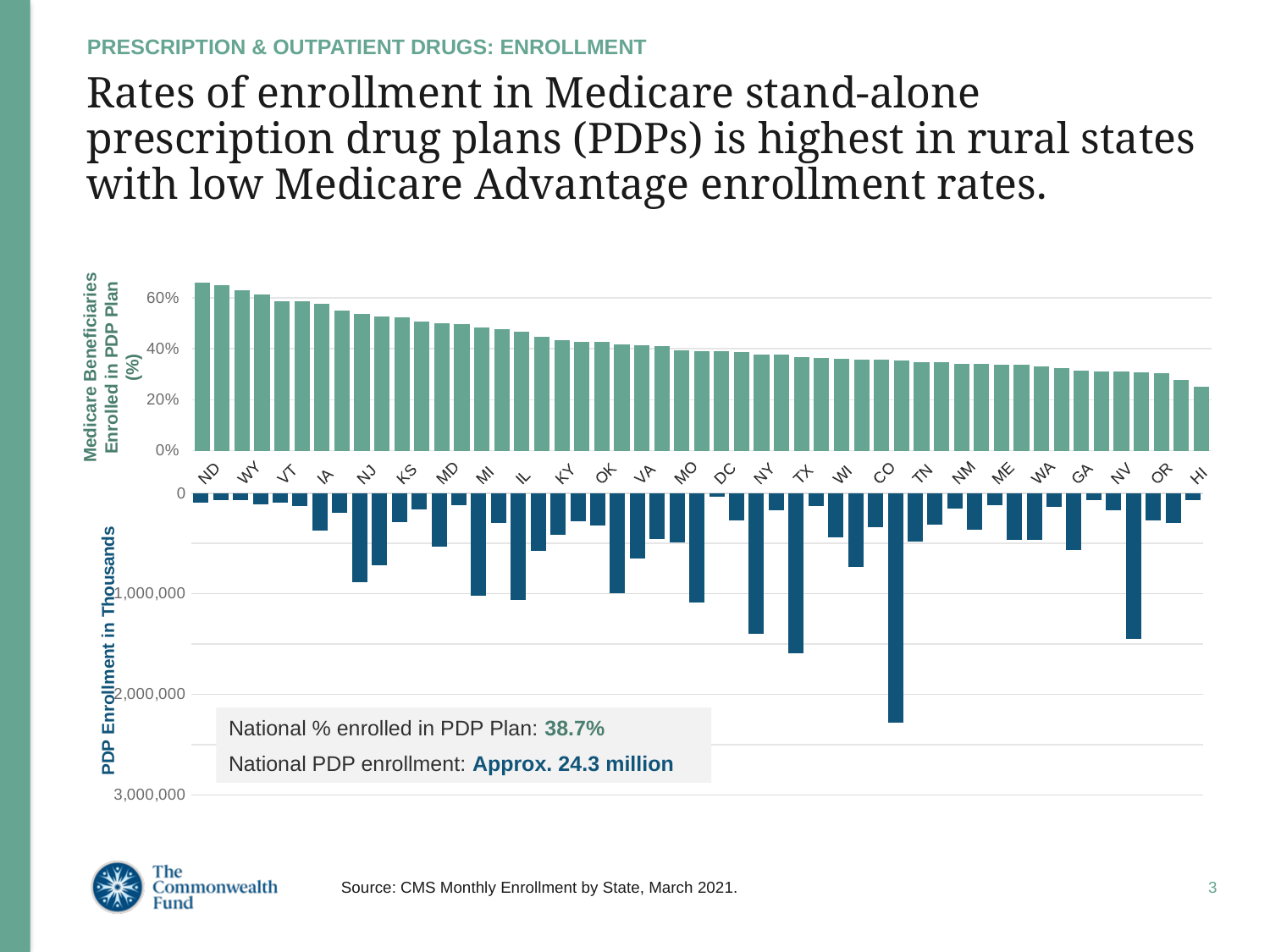
In the top chart, is the value for OR greater or less than 40%? less In the top chart, do the PDP enrollment percentages rise or fall moving from left to right across the states? fall What kind of chart is the top chart on the slide? bar chart In the top chart, is the value for ND greater or less than 60%? greater In the top chart, which state has a higher PDP enrollment percentage, WY or MI? WY In the bottom chart, is the PDP enrollment for TX greater or less than 1,000,000? greater What national percentage enrolled in a PDP plan is stated on the slide? 38.7% In the top chart, which state has the lowest percentage of Medicare beneficiaries enrolled in a PDP plan? HI In the top chart, which state has the highest percentage of Medicare beneficiaries enrolled in a PDP plan? ND